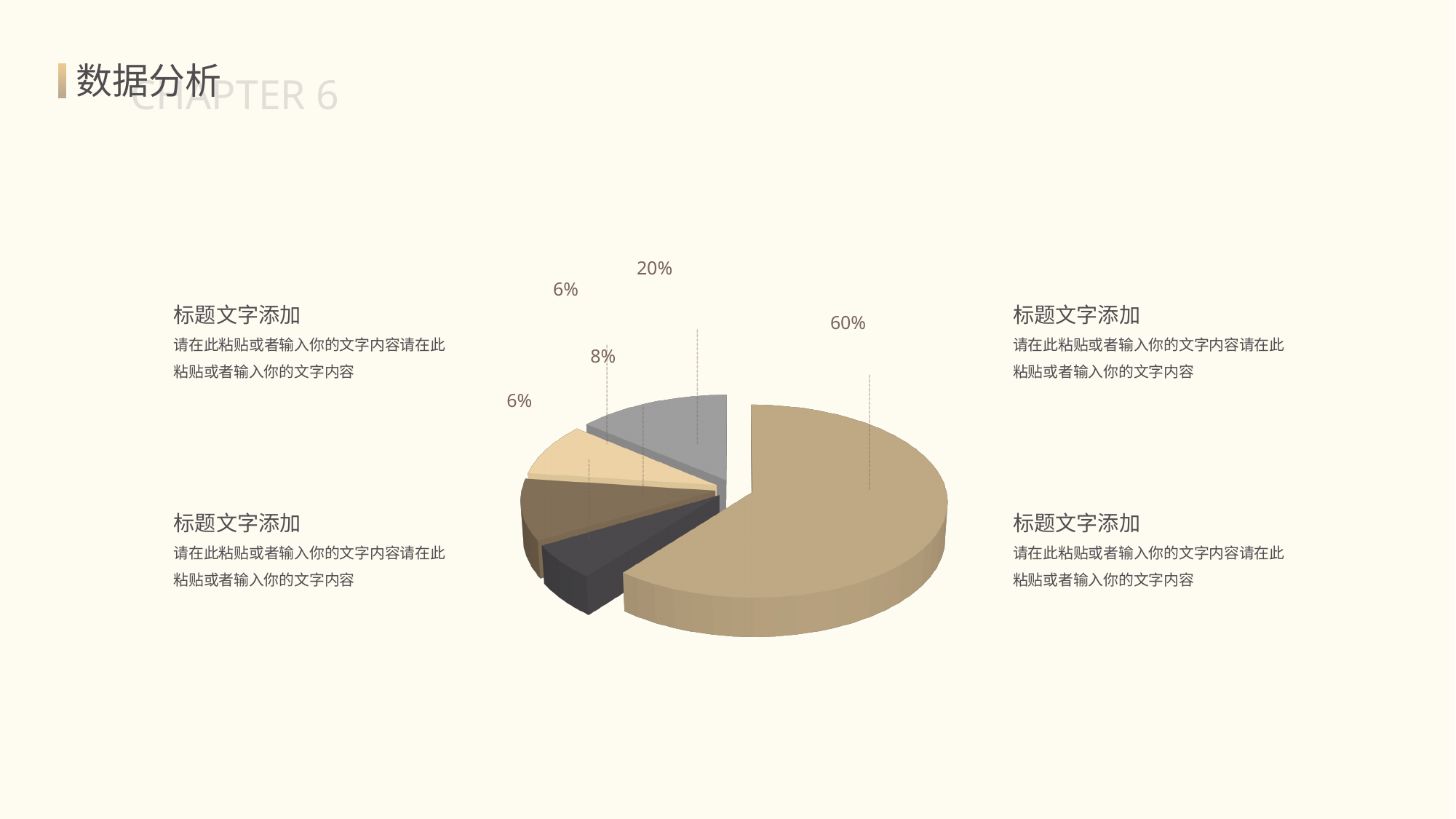
What is the value of the largest slice in the pie chart? 60% What percentage is shown for the gray slice at the top of the pie chart? 20% How many slices does the pie chart have? 5 Is the largest slice greater or less than 50% of the pie? greater What percentage is shown for the large tan slice on the right of the pie chart? 60% What is the value of the smallest slice in the pie chart? 6% How many slices in the pie chart are labelled 6%? 2 What is the heading text at the top of the slide? 数据分析 What do the five slice percentages add up to? 100% Which is larger, the 20% slice or the 8% slice? the 20% slice What is the difference between the largest slice (60%) and the 20% slice? 40 percentage points What kind of chart is shown on the slide? pie chart